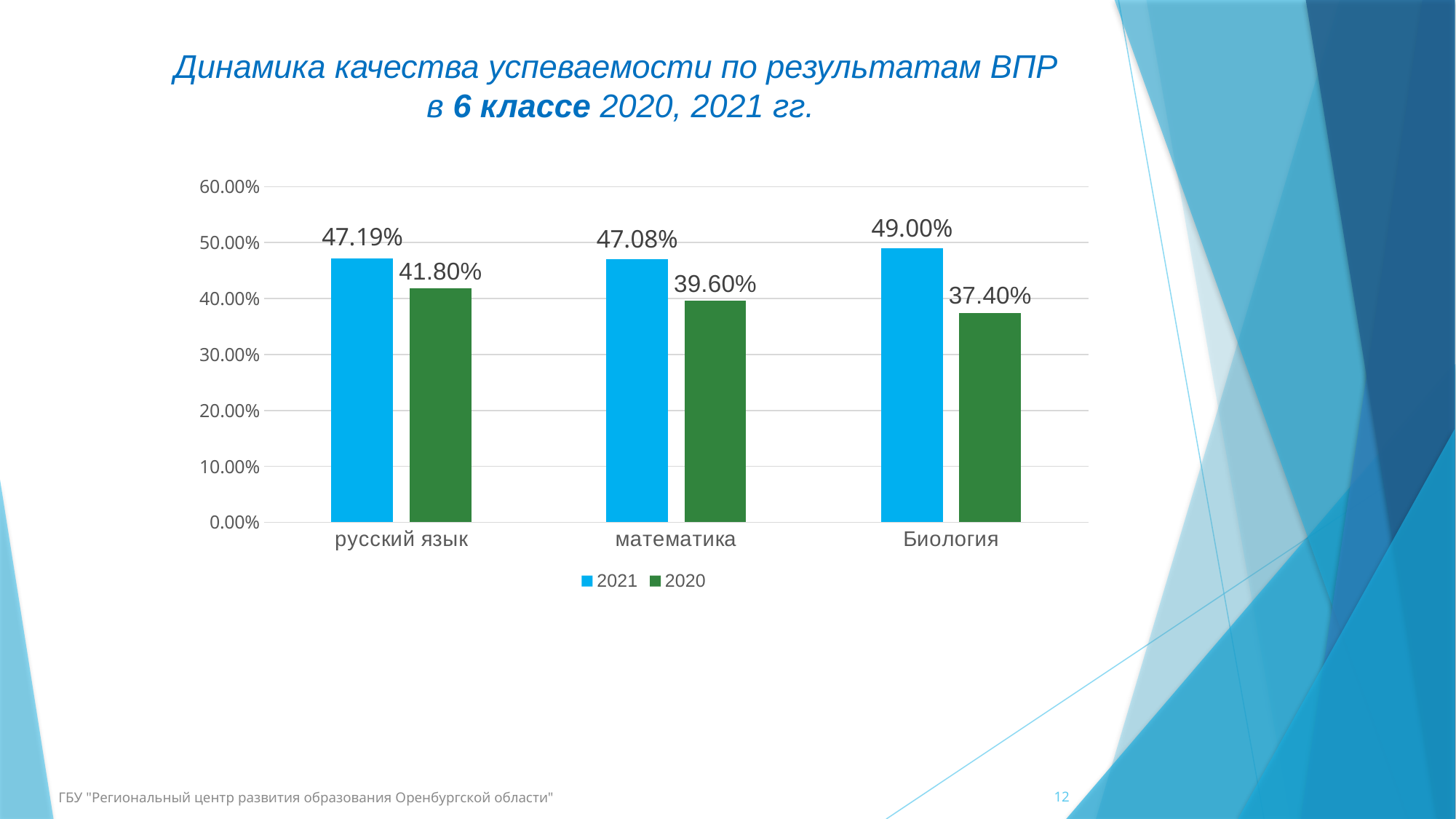
Which colour represents the 2020 series? green How many series does the legend list? 2 What is the 2020 value for Биология? 37.40% What is the 2020 value for математика? 39.60% How many subjects are shown on the x axis? 3 Which subject has the lowest 2020 value? Биология Which subject has the highest 2021 value? Биология What is the 2021 value for русский язык? 47.19% What is the difference between the 2021 and 2020 values for математика? 7.48% What is the difference between the 2021 and 2020 values for Биология? 11.60% What kind of chart is shown on the slide? bar chart Which is larger for русский язык: the 2021 value or the 2020 value? 2021